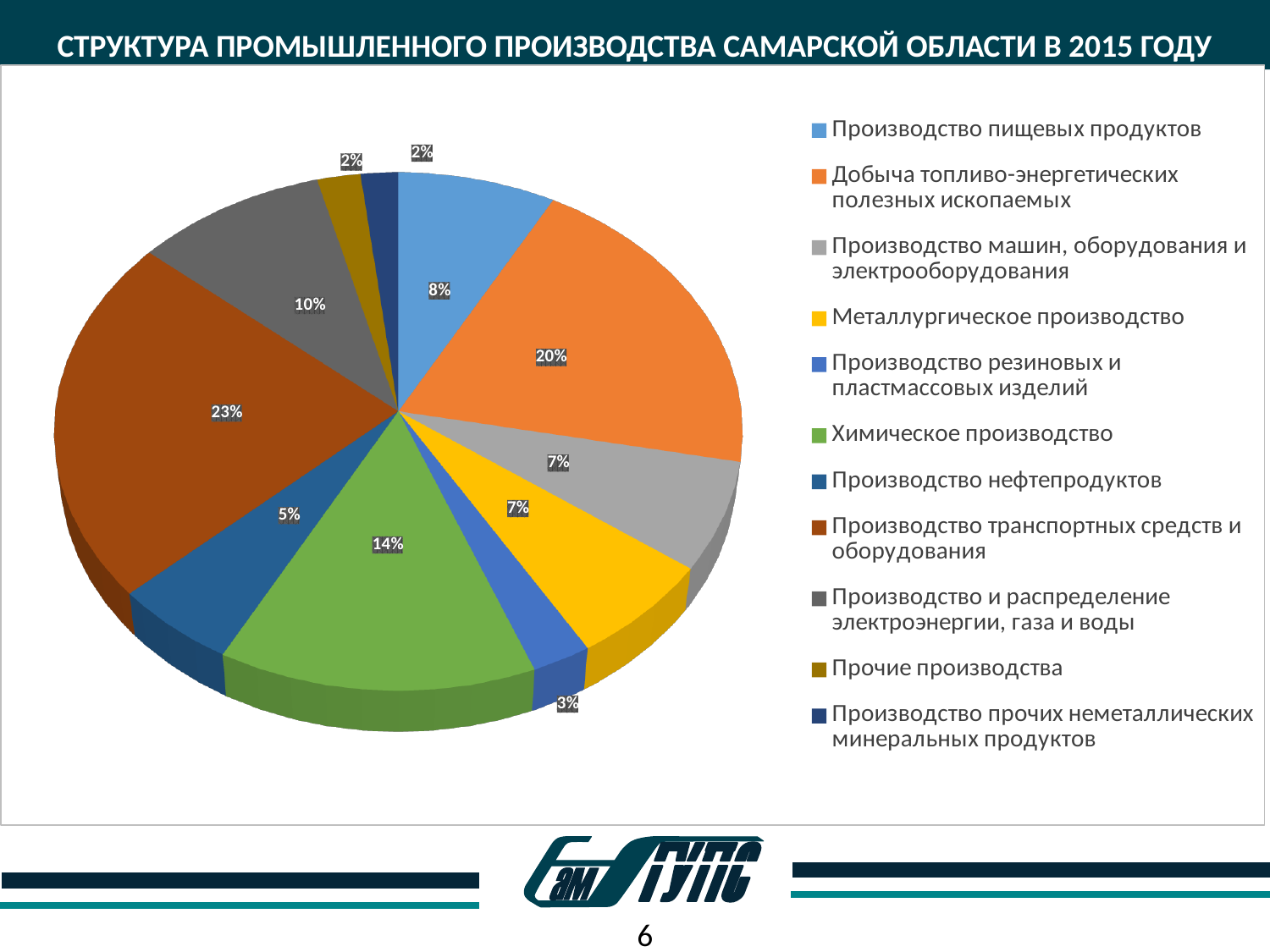
How many categories does the pie chart contain? 11 What is the share of Производство пищевых продуктов? 8% What is the share of Химическое производство? 14% What kind of chart is shown on the slide? Pie chart What is the share of Добыча топливо-энергетических полезных ископаемых? 20% What is the title of the chart? СТРУКТУРА ПРОМЫШЛЕННОГО ПРОИЗВОДСТВА САМАРСКОЙ ОБЛАСТИ В 2015 ГОДУ What is the share of Производство транспортных средств и оборудования? 23% Which is larger: the share of Химическое производство or the share of Производство нефтепродуктов? Химическое производство What is the share of Производство и распределение электроэнергии, газа и воды? 10% What is the share of Производство резиновых и пластмассовых изделий? 3% What is the difference in percentage points between Производство транспортных средств и оборудования and Добыча топливо-энергетических полезных ископаемых? 3 percentage points Which category has the largest share of the pie? Производство транспортных средств и оборудования